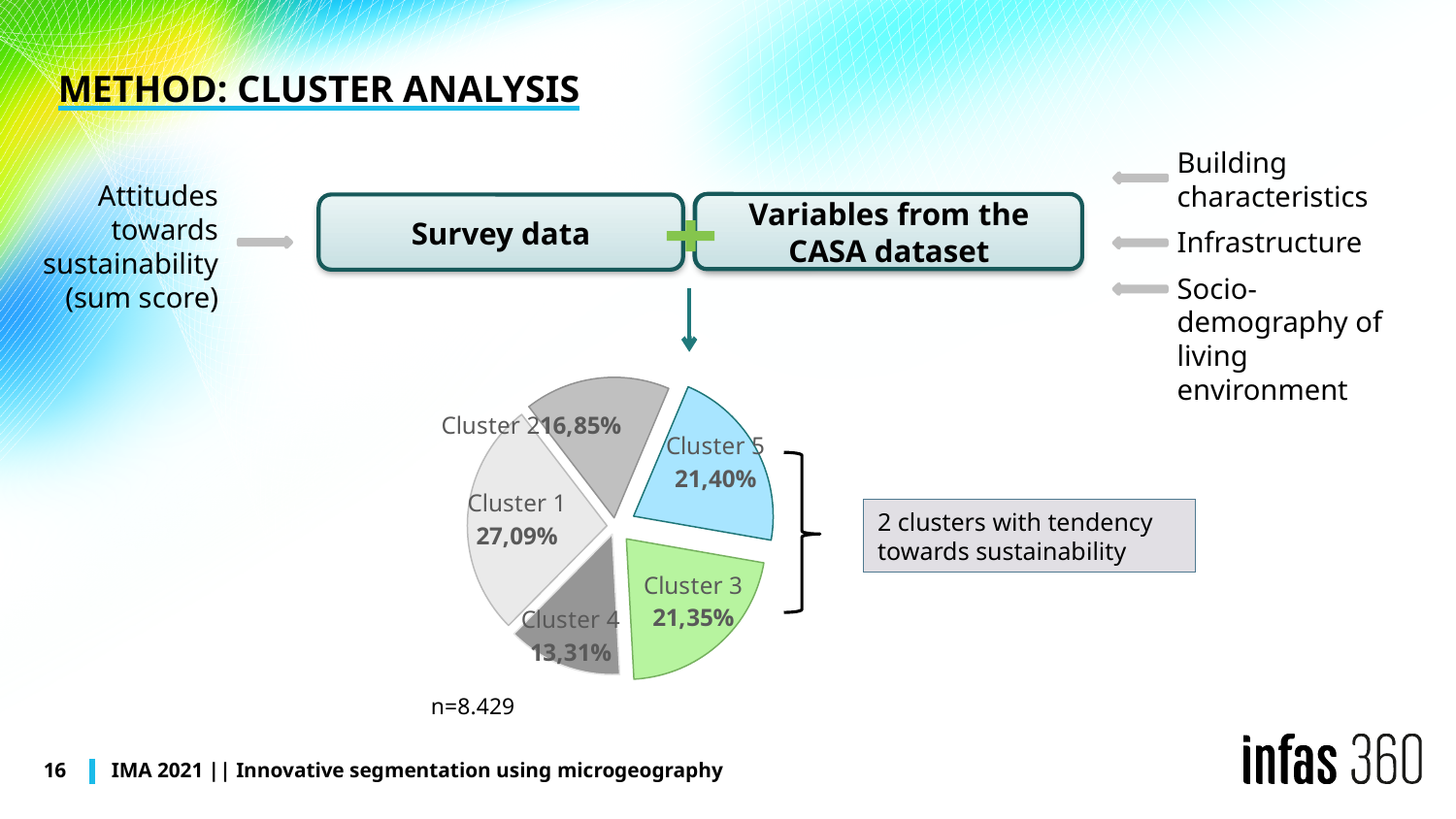
What is the share of Cluster 4 in the pie chart? 13,31% Which cluster has the smallest share in the pie chart? Cluster 4 Which cluster has the largest share in the pie chart? Cluster 1 What type of chart is shown on the slide? pie chart What is the share of Cluster 5 in the pie chart? 21,40% What sample size (n) is stated below the pie chart? n=8.429 How many clusters (slices) does the pie chart show? 5 What is the share of Cluster 2 in the pie chart? 16,85% What is the share of Cluster 3 in the pie chart? 21,35% What is the share of Cluster 1 in the pie chart? 27,09% What is the difference in percentage points between Cluster 1 and Cluster 4? 13,78 Which has a larger share, Cluster 1 or Cluster 2? Cluster 1